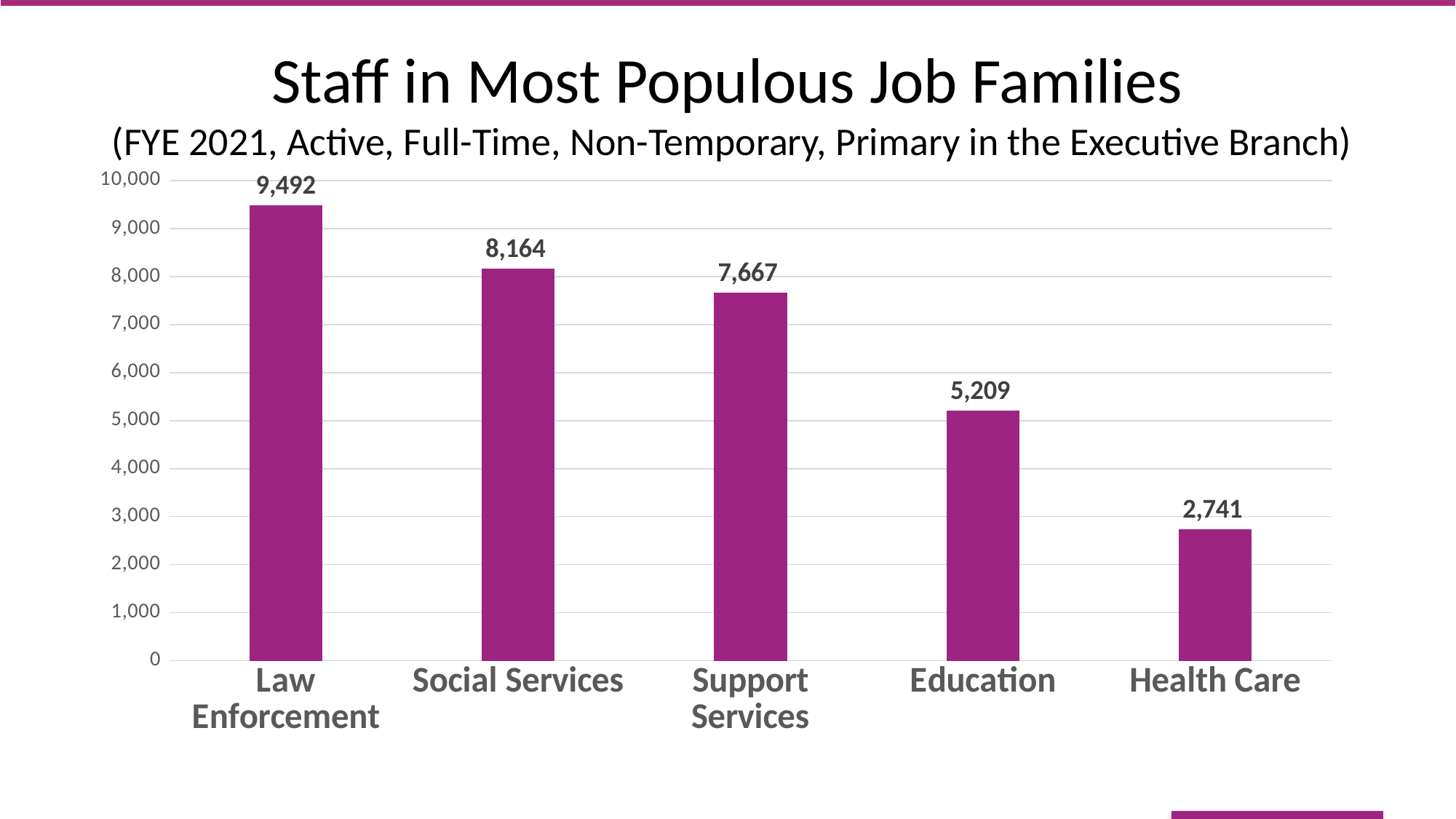
What kind of chart is this? Bar chart Which job family has the lowest number of staff? Health Care Do the values rise or fall from left to right across the x axis? Fall Which is larger, Education or Support Services? Support Services What is the value for Health Care? 2,741 What is the value for Education? 5,209 What is the difference between Social Services and Support Services? 497 How many job families are shown in the chart? 5 Which job family has the highest number of staff? Law Enforcement Is the value for Social Services greater or less than 8,000? greater What is the difference between Law Enforcement and Health Care? 6,751 What is the value for Law Enforcement? 9,492